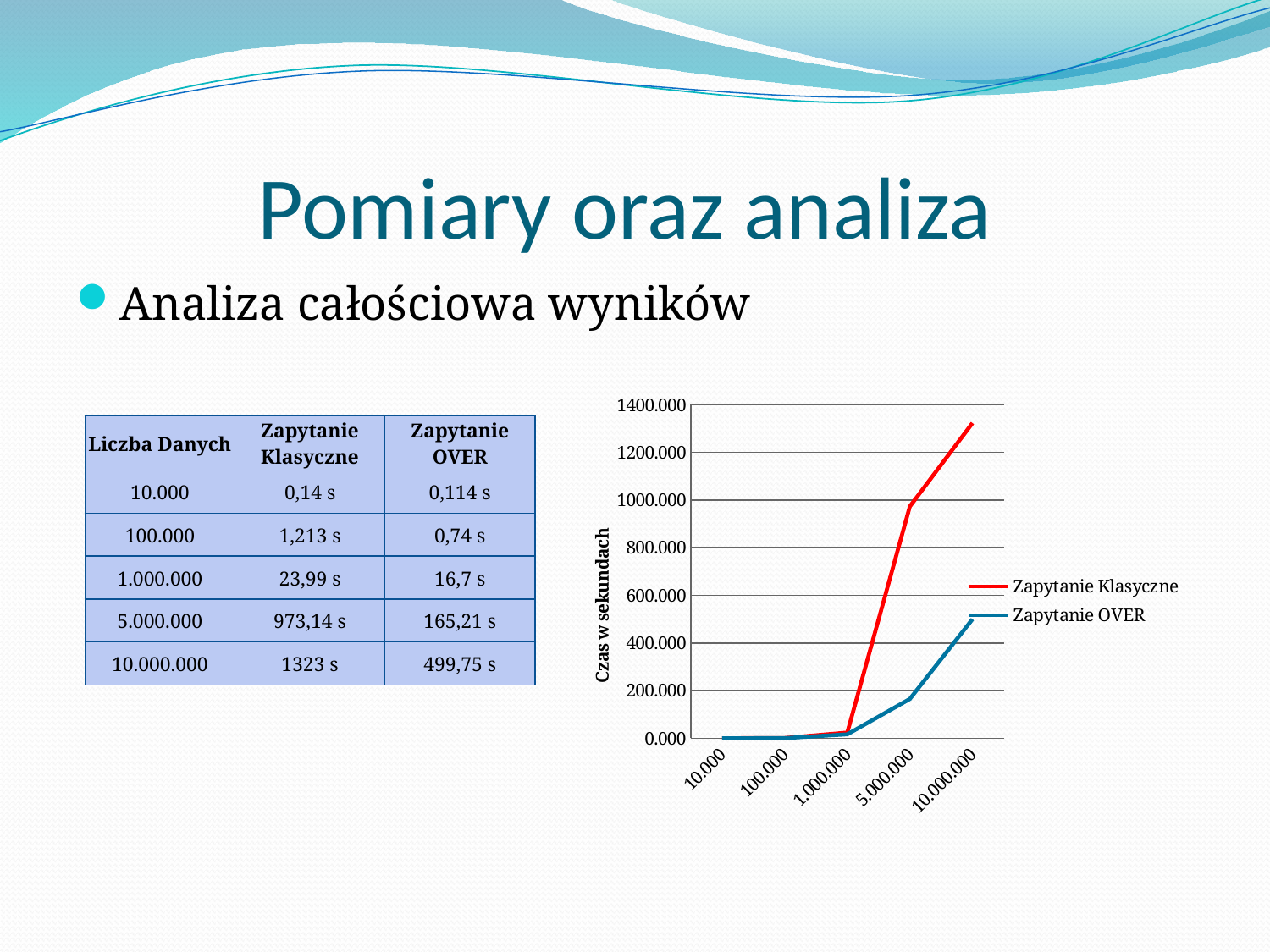
Do the values for Zapytanie OVER rise or fall as the number of records increases along the x axis? rise What is the title of the vertical axis of the chart? Czas w sekundach Is the value for Zapytanie Klasyczne at 10.000.000 greater or less than 1200.000? greater Is the value for Zapytanie Klasyczne at 5.000.000 greater or less than 800.000? greater Is the value for Zapytanie OVER at 5.000.000 greater or less than 200.000? less What kind of chart is shown on the slide? line chart At which x-axis category does Zapytanie Klasyczne reach its highest value? 10.000.000 How many data points are plotted along the x axis of the chart? 5 Which series is drawn in red on the chart? Zapytanie Klasyczne How many series does the chart legend list? 2 At 10.000.000, which series has the larger value, Zapytanie Klasyczne or Zapytanie OVER? Zapytanie Klasyczne